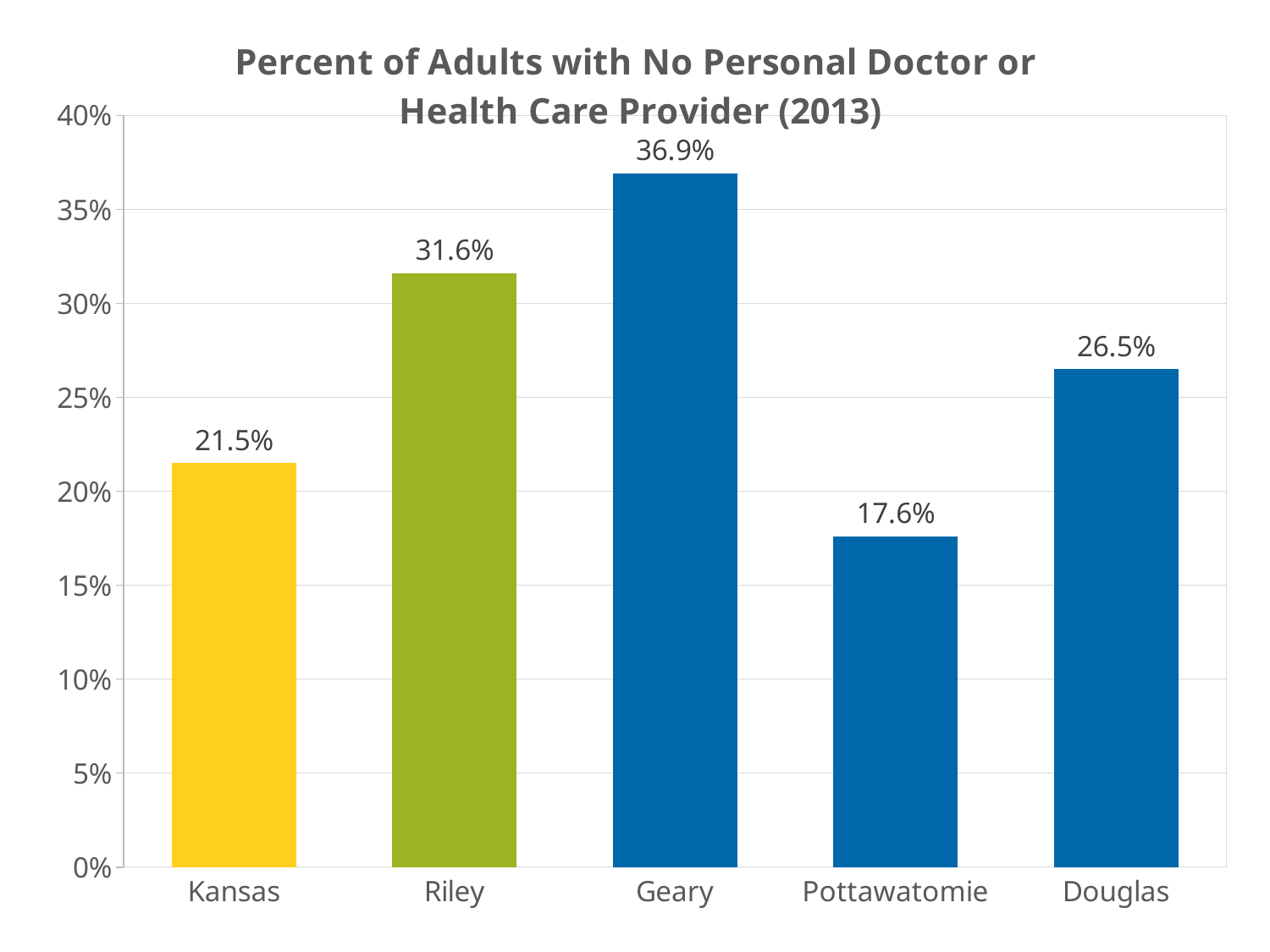
How many categories are shown on the x axis? 5 Is the value for Geary greater or less than 35%? greater What is the value for Riley? 31.6% What kind of chart is this? bar chart What is the difference between the values for Douglas and Kansas? 5.0% Which is larger, the value for Douglas or the value for Kansas? Douglas What is the title of the chart? Percent of Adults with No Personal Doctor or Health Care Provider (2013) What is the difference between the values for Geary and Riley? 5.3% Which category has the highest value? Geary What is the value for Kansas? 21.5% What is the value for Pottawatomie? 17.6% Which category has the lowest value? Pottawatomie